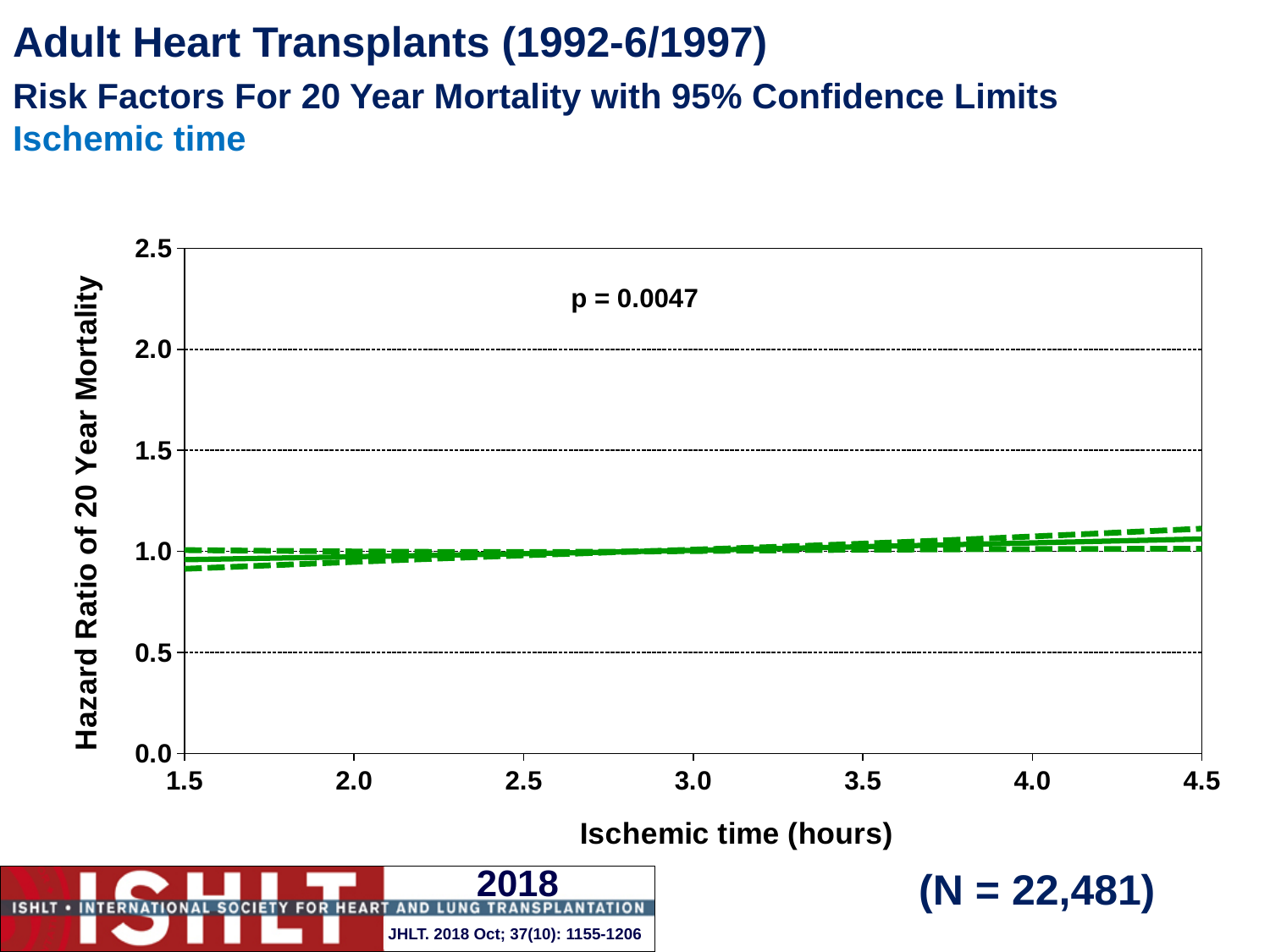
What p-value is printed on the chart? p = 0.0047 Is the hazard ratio at an ischemic time of 4.5 hours greater or less than 1.5? less What is the range of ischemic time shown on the x axis? 1.5 to 4.5 hours Does the hazard ratio of 20 year mortality rise or fall as ischemic time increases from 1.5 to 4.5 hours? Rises What kind of chart is shown on the slide? Line chart Is the hazard ratio higher at an ischemic time of 4.5 hours or at 1.5 hours? 4.5 hours What is the label of the y axis? Hazard Ratio of 20 Year Mortality How many lines are plotted on the chart (the estimate plus its confidence limits)? 3 What is the maximum value shown on the y axis? 2.5 Is the hazard ratio at an ischemic time of 1.5 hours greater or less than 0.5? greater Is the hazard ratio at an ischemic time of 4.5 hours greater or less than 1.0? greater